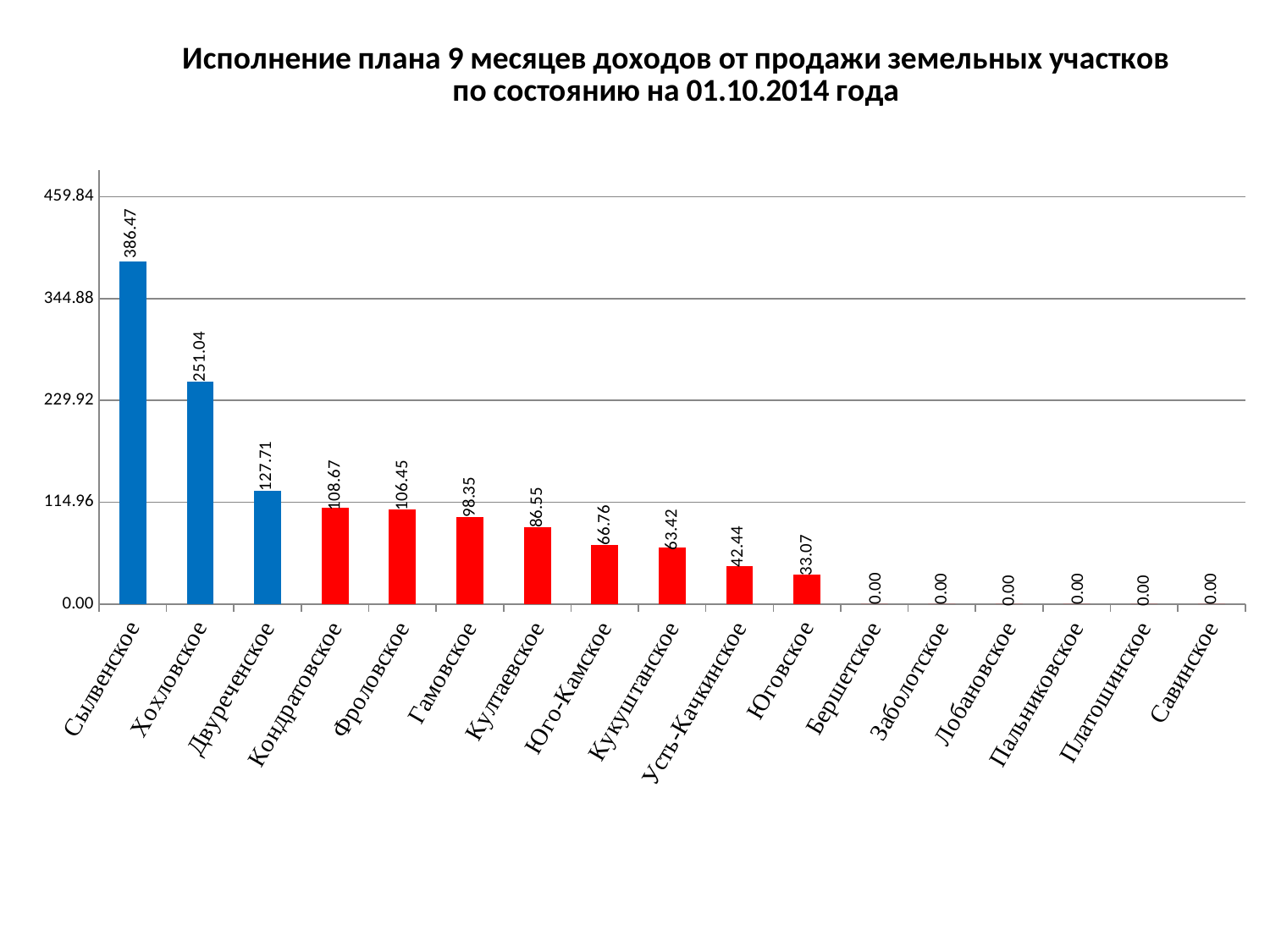
Which is larger, the value for Двуреченское or the value for Култаевское? Двуреченское What is the difference between the values for Кондратовское and Фроловское? 2.22 How many categories have a value of 0.00? 6 How many categories are shown on the x axis? 17 What is the value for Сылвенское? 386.47 What is the value for Гамовское? 98.35 What is the value for Хохловское? 251.04 What is the difference between the values for Сылвенское and Хохловское? 135.43 Do the values rise or fall from left to right along the x axis? Fall What kind of chart is shown on the slide? Bar chart What is the value for Юговское? 33.07 Which category has the highest value? Сылвенское